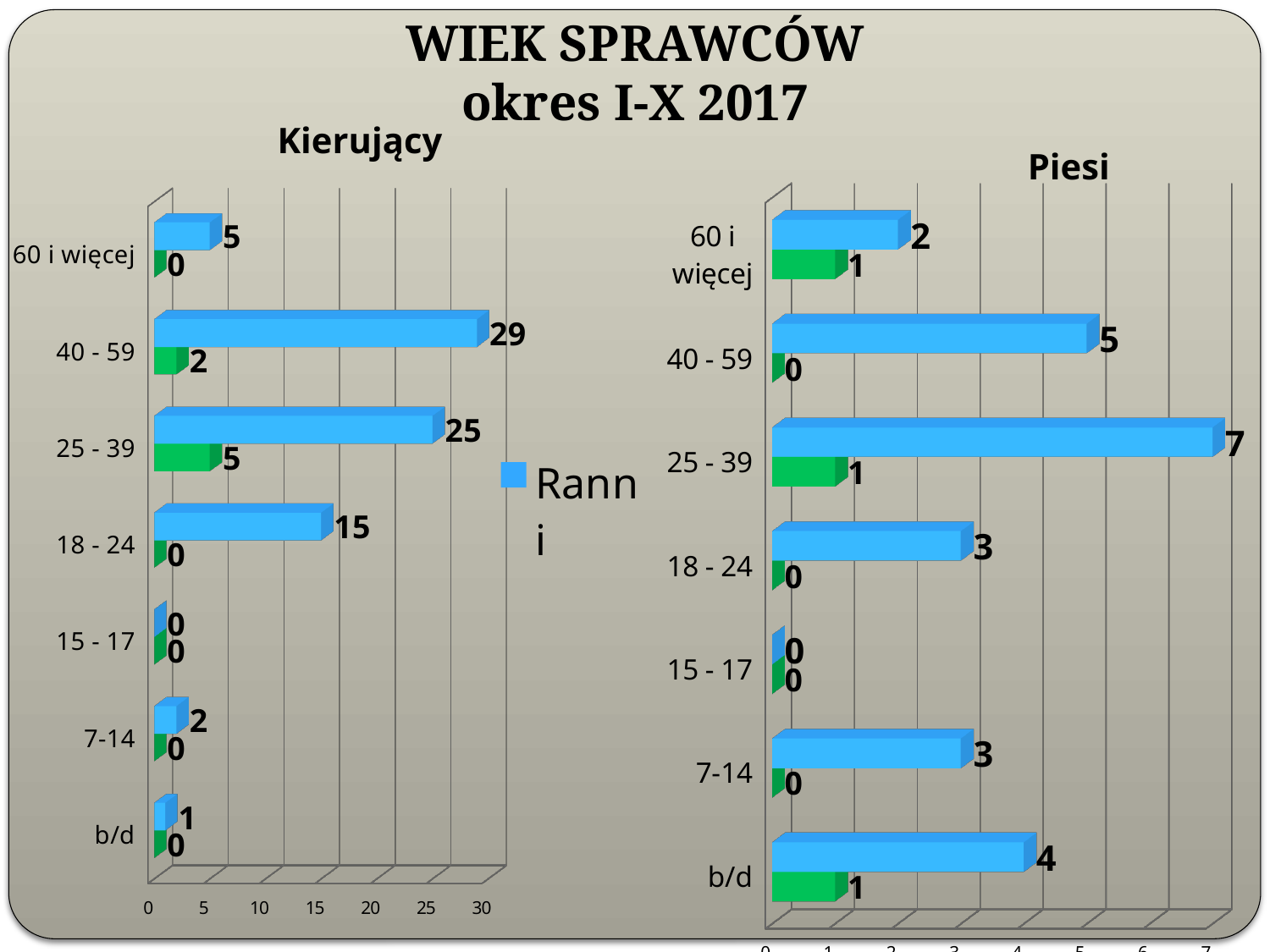
What is the main title of the slide? WIEK SPRAWCÓW okres I-X 2017 In the Piesi chart, what is the difference between the Ranni values for 25 - 39 and 40 - 59? 2 In the Kierujący chart, which is larger: the Ranni value for 18 - 24 or for 60 i więcej? 18 - 24 In the Piesi chart, which is larger: the Ranni value for b/d or for 60 i więcej? b/d In the Piesi chart, which age group has the highest Ranni value? 25 - 39 In the Kierujący chart, which age group has the highest Ranni value? 40 - 59 In the Piesi chart, what is the Ranni value for the 25 - 39 age group? 7 In the Kierujący chart, what is the Ranni value for the 40 - 59 age group? 29 In the Kierujący chart, what is the difference between the Ranni values for 40 - 59 and 25 - 39? 4 In the Kierujący chart, what is the value of the green bar for the 25 - 39 age group? 5 What type of chart is the Piesi chart? bar chart How many age categories are shown in the Kierujący chart? 7